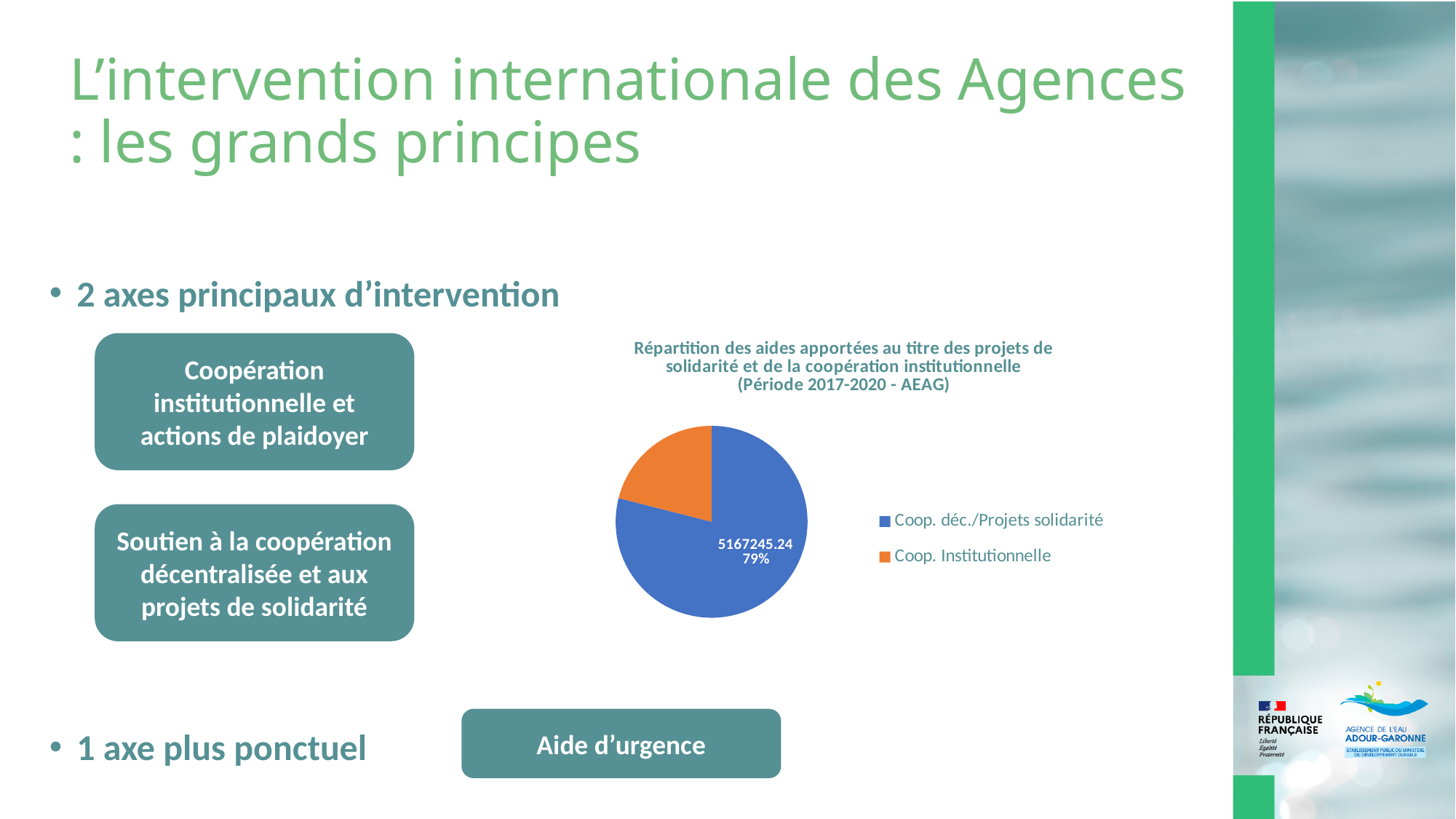
How many entries does the legend of the pie chart list? 2 What kind of chart is shown on the slide? pie chart What colour is the Coop. Institutionnelle slice in the pie chart? orange What period does the pie chart title say the data covers? 2017-2020 How many slices does the pie chart have? 2 What share of the pie does Coop. déc./Projets solidarité represent? 79% Which category has the smallest slice in the pie chart? Coop. Institutionnelle Which category has the largest slice in the pie chart? Coop. déc./Projets solidarité What value is printed on the Coop. déc./Projets solidarité slice of the pie chart? 5167245.24 Which is larger in the pie chart, Coop. déc./Projets solidarité or Coop. Institutionnelle? Coop. déc./Projets solidarité